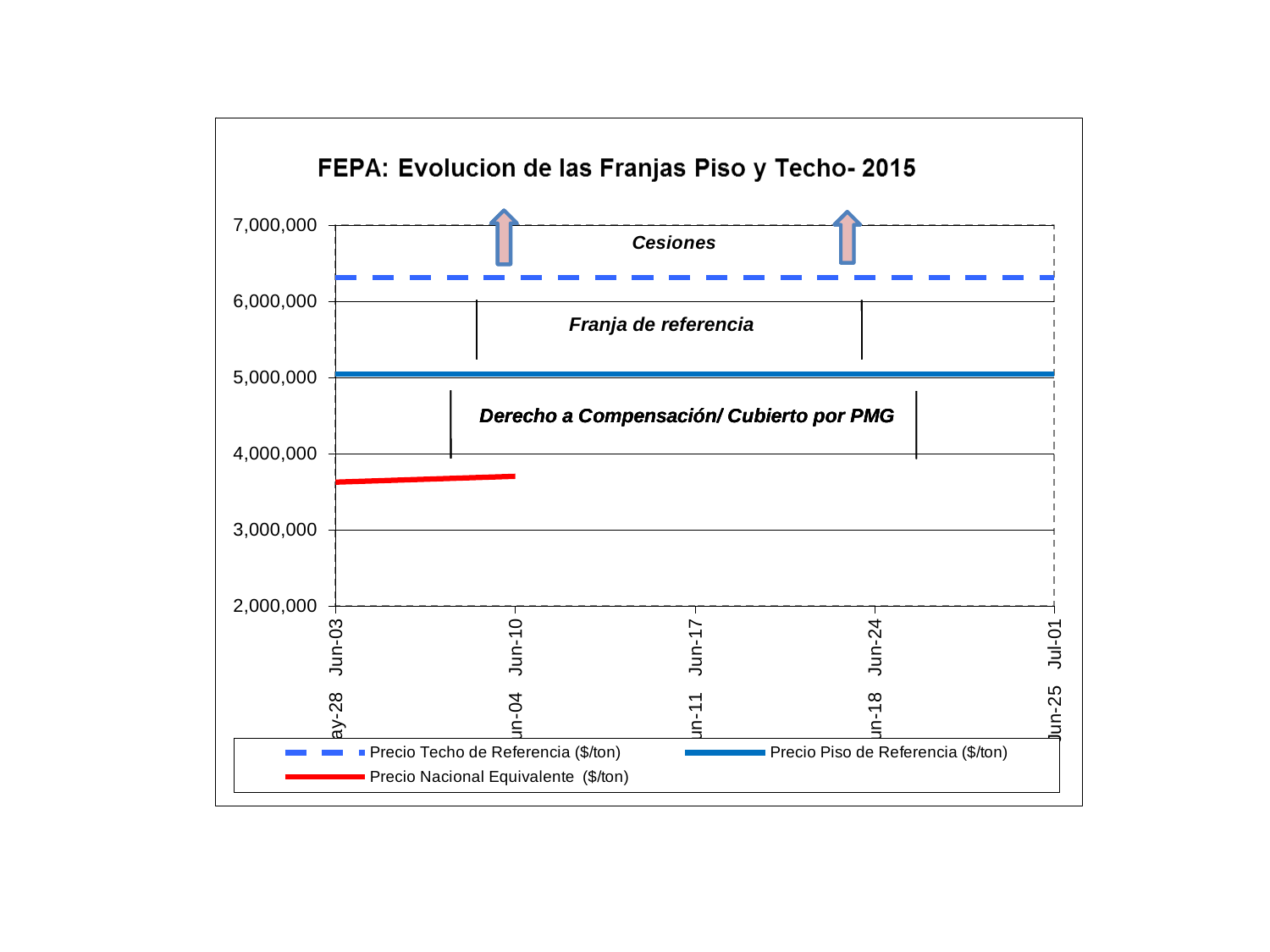
Does the Precio Nacional Equivalente ($/ton) line rise or fall from Jun-03 to Jun-10? rise Which series is drawn as a dashed blue line? Precio Techo de Referencia ($/ton) Which series has the highest values, Precio Techo de Referencia ($/ton) or Precio Piso de Referencia ($/ton)? Precio Techo de Referencia ($/ton) Which of the three series has the lowest values on the chart? Precio Nacional Equivalente ($/ton) Is the value of Precio Nacional Equivalente ($/ton) greater or less than 4,000,000? less Is the value of Precio Piso de Referencia ($/ton) greater or less than 6,000,000? less What is the title of the chart? FEPA: Evolucion de las Franjas Piso y Techo- 2015 What kind of chart is shown on the slide? line chart Is the value of Precio Techo de Referencia ($/ton) greater or less than 6,000,000? greater How many series does the legend list? 3